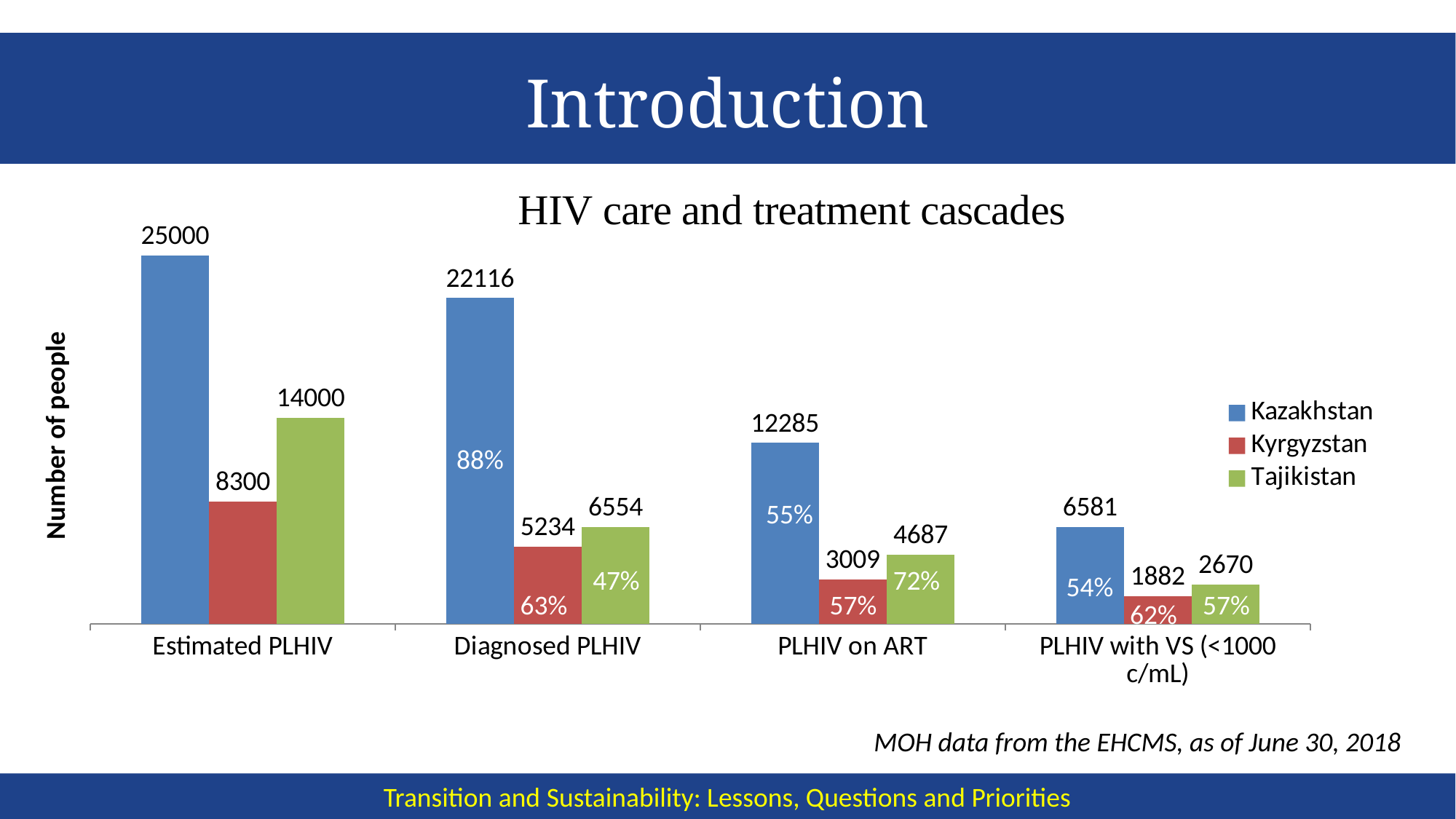
What is the PLHIV with VS (<1000 c/mL) value for Kazakhstan? 6581 How many categories are shown on the x axis? 4 What is the PLHIV on ART value for Kyrgyzstan? 3009 Which country has the highest PLHIV on ART value? Kazakhstan What kind of chart is shown on the slide? Bar chart Do the Kazakhstan values rise or fall across the categories from Estimated PLHIV to PLHIV with VS (<1000 c/mL)? Fall What is the Estimated PLHIV value for Kazakhstan? 25000 Which is larger: the PLHIV with VS (<1000 c/mL) value for Tajikistan or for Kyrgyzstan? Tajikistan How many series does the legend list? 3 What is the Diagnosed PLHIV value for Tajikistan? 6554 Which country has the lowest Estimated PLHIV value? Kyrgyzstan What is the difference between the Estimated PLHIV and Diagnosed PLHIV values for Kazakhstan? 2884